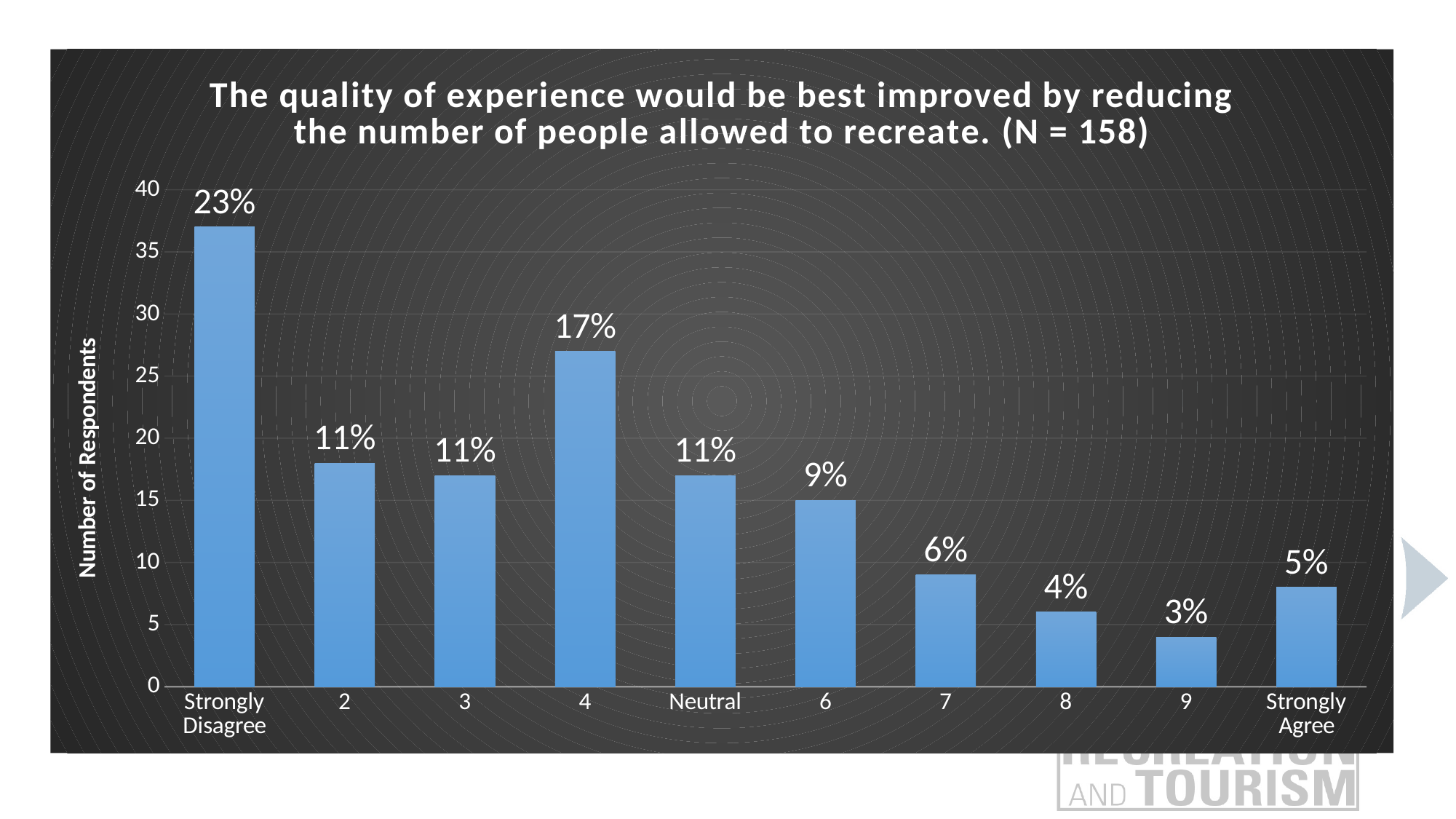
Which category has the lowest bar? 9 How many categories are shown on the x axis? 10 What is the difference in percentage points between the labels for Strongly Disagree and category 4? 6% What percentage label is shown on the bar for Strongly Disagree? 23% What percentage label is shown on the bar for Strongly Agree? 5% Which has a higher bar, category 6 or category 7? 6 What percentage label is shown on the bar for category 4? 17% Which category has the highest bar? Strongly Disagree Is the number of respondents for Strongly Disagree greater or less than 35? greater What kind of chart is shown on the slide? Bar chart What percentage label is shown on the bar for category 9? 3% Is the number of respondents for category 8 greater or less than 10? less